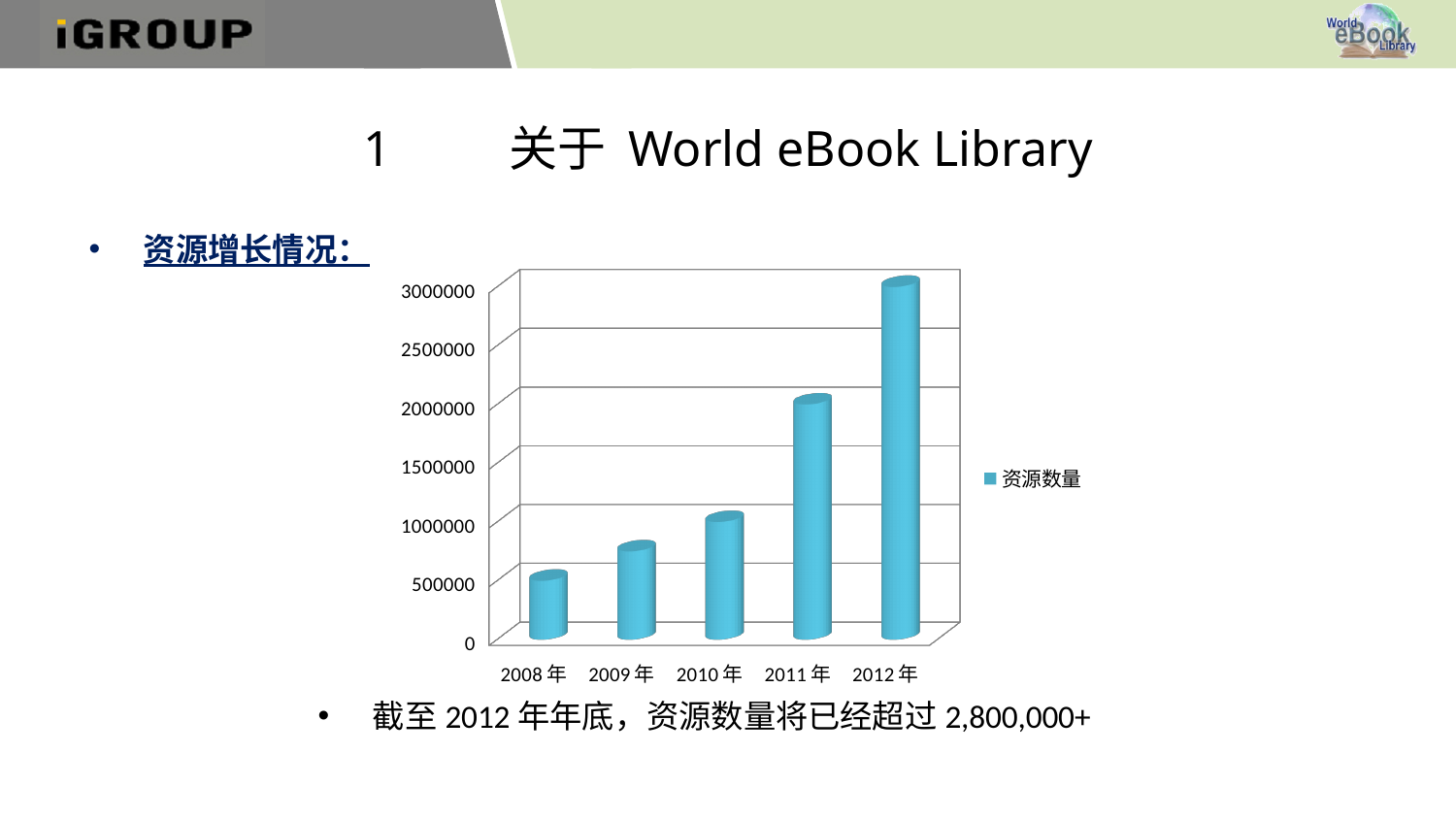
Which is larger, the value for 2011年 or the value for 2010年? 2011年 Which year has the highest value in the chart? 2012年 What is the name of the series shown in the chart's legend? 资源数量 Is the value for 2008年 greater or less than 1000000? less Is the value for 2009年 greater or less than 1000000? less What kind of chart is shown on the slide? bar chart Is the value for 2012年 greater or less than 2500000? greater How many series does the chart's legend list? 1 Do the values rise or fall from 2008年 to 2012年? rise How many categories (years) are shown on the x axis of the chart? 5 Which year has the lowest value in the chart? 2008年